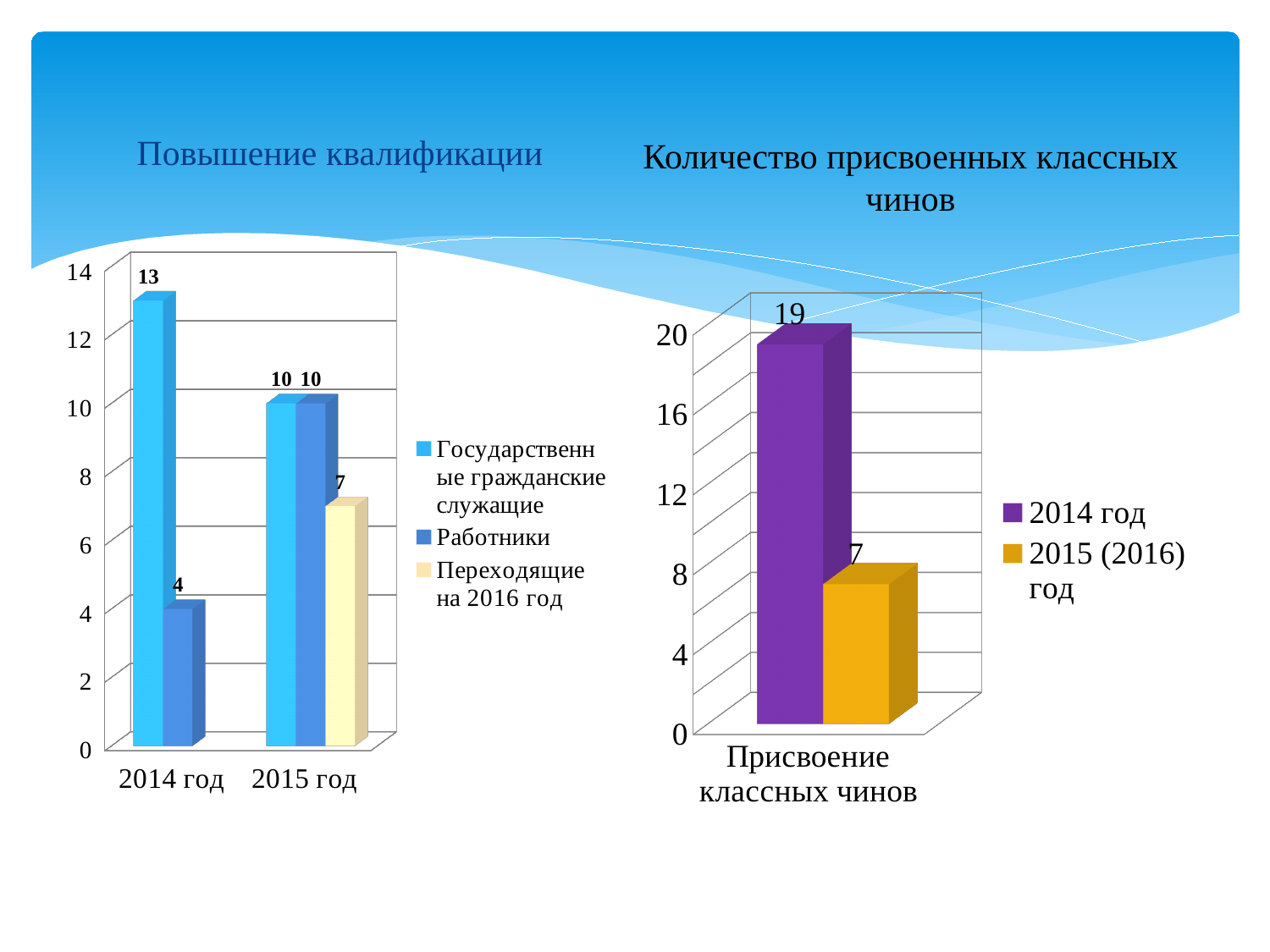
What kind of chart is the one titled "Количество присвоенных классных чинов"? bar chart In the chart titled "Повышение квалификации", what is the value for Переходящие на 2016 год in 2015 год? 7 In the chart titled "Повышение квалификации", what is the value for Работники in 2014 год? 4 In the chart titled "Повышение квалификации", what is the difference between Государственные гражданские служащие and Работники in 2014 год? 9 In the chart titled "Количество присвоенных классных чинов", what is the difference between the 2014 год and 2015 (2016) год values? 12 In the chart titled "Количество присвоенных классных чинов", what is the value for 2014 год? 19 In the chart titled "Количество присвоенных классных чинов", what is the value for 2015 (2016) год? 7 In the chart titled "Повышение квалификации", how many series does the legend list? 3 In the chart titled "Повышение квалификации", does the value for Государственные гражданские служащие rise or fall from 2014 год to 2015 год? fall In the chart titled "Повышение квалификации", which is larger in 2014 год: Государственные гражданские служащие or Работники? Государственные гражданские служащие In the chart titled "Повышение квалификации", how many categories are shown on the x axis? 2 In the chart titled "Повышение квалификации", what is the value for Государственные гражданские служащие in 2014 год? 13